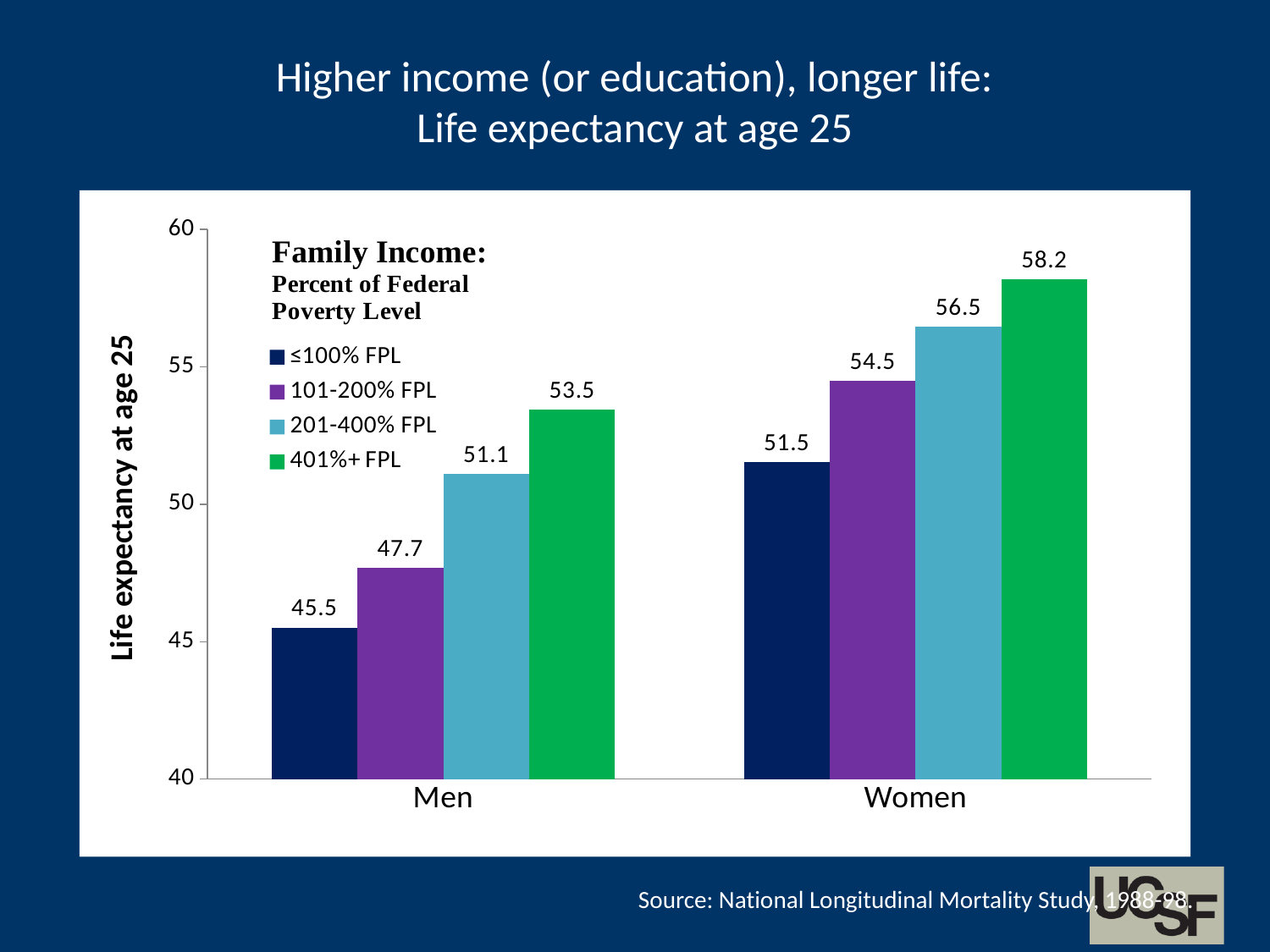
What is the life expectancy at age 25 for women with family income 401%+ FPL? 58.2 What is the value for women in the 201-400% FPL group? 56.5 Which income group has the lowest life expectancy among women? ≤100% FPL What is the label of the vertical axis? Life expectancy at age 25 What kind of chart is shown on the slide? Bar chart What is the life expectancy at age 25 for men with family income ≤100% FPL? 45.5 What is the difference between the 401%+ FPL and ≤100% FPL values for men? 8.0 Which is larger: the value for men at 401%+ FPL or the value for women at ≤100% FPL? Men at 401%+ FPL What is the value for men in the 101-200% FPL group? 47.7 How many series does the legend list? 4 Which income group has the highest life expectancy among men? 401%+ FPL What is the difference in life expectancy between women and men in the 401%+ FPL group? 4.7